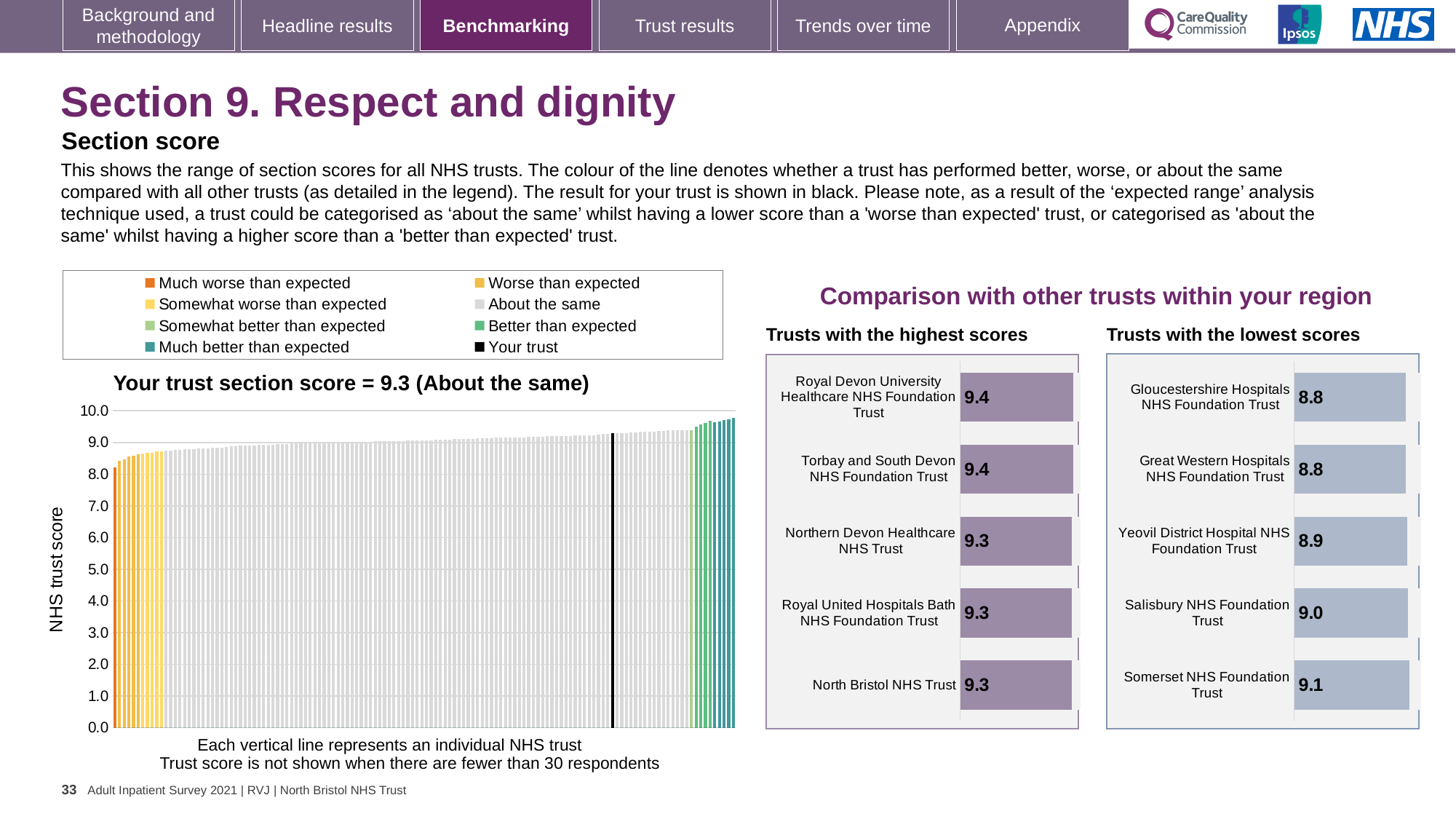
On the 'Trusts with the lowest scores' chart, which trust has the highest score? Somerset NHS Foundation Trust On the 'Trusts with the highest scores' chart, how many trusts are shown? 5 On the 'Trusts with the highest scores' chart, what is the difference between the scores of Royal Devon University Healthcare NHS Foundation Trust and North Bristol NHS Trust? 0.1 On the 'Trusts with the lowest scores' chart, what is the difference between the scores of Somerset NHS Foundation Trust and Gloucestershire Hospitals NHS Foundation Trust? 0.3 On the 'Trusts with the lowest scores' chart, which has the larger score, Yeovil District Hospital NHS Foundation Trust or Salisbury NHS Foundation Trust? Salisbury NHS Foundation Trust On the 'Trusts with the highest scores' chart, what is the score for Northern Devon Healthcare NHS Trust? 9.3 On the 'Your trust section score' chart, what is the label of the vertical axis? NHS trust score On the 'Your trust section score' chart, how many entries does the legend list? 8 On the 'Your trust section score' chart, what is the section score for your trust? 9.3 On the 'Trusts with the lowest scores' chart, what is the score for Yeovil District Hospital NHS Foundation Trust? 8.9 On the 'Your trust section score' chart, is the value of the lowest-scoring trust greater or less than 9.0? less On the 'Your trust section score' chart, what kind of chart is shown? bar chart